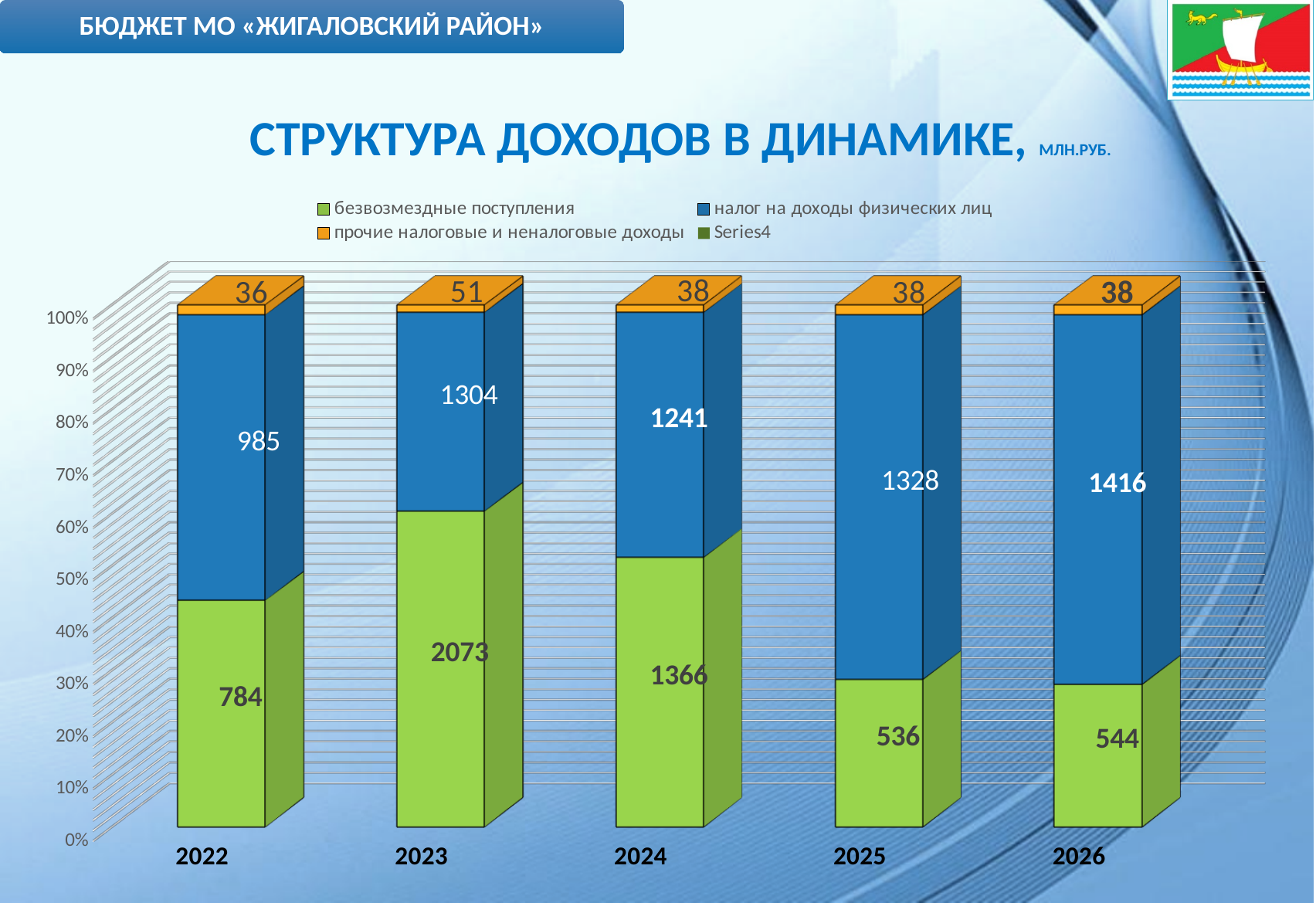
What is the value of прочие налоговые и неналоговые доходы for 2022? 36 How many years are shown on the x axis? 5 In which year is безвозмездные поступления lowest? 2025 What is the value of безвозмездные поступления for 2023? 2073 What is the unit given next to the chart title? млн.руб. In which year is налог на доходы физических лиц highest? 2026 What kind of chart is shown on the slide? stacked bar chart How many series does the legend list? 4 What is the total of the three labelled values in the 2025 bar? 1902 What is the difference between безвозмездные поступления in 2023 and in 2024? 707 Which is larger in 2022: безвозмездные поступления or налог на доходы физических лиц? налог на доходы физических лиц What is the value of налог на доходы физических лиц for 2026? 1416